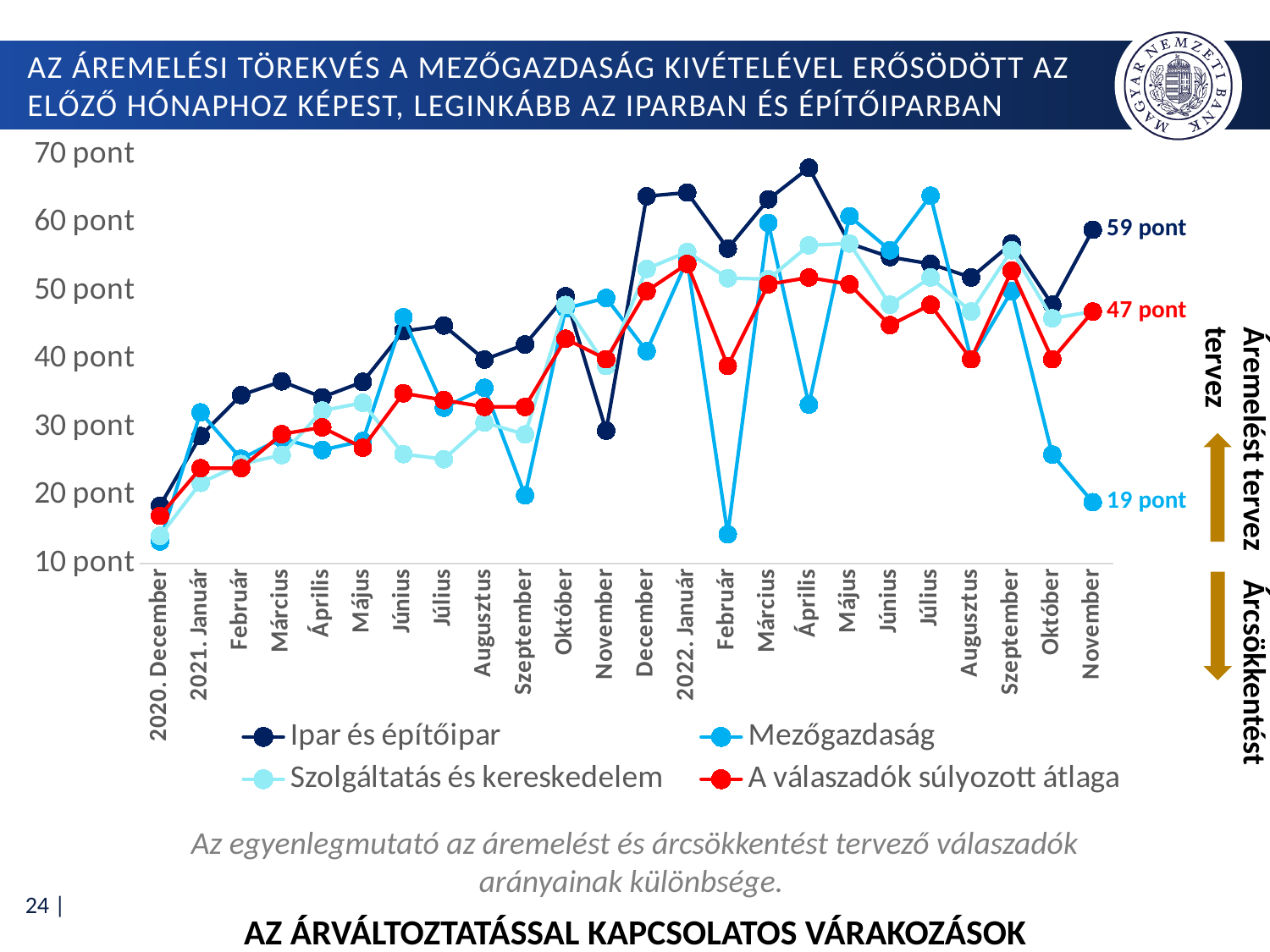
Which series has the highest value in November 2022? Ipar és építőipar What is the value for Ipar és építőipar in November 2022? 59 pont What is the difference between the November 2022 values of Ipar és építőipar and Mezőgazdaság? 40 pont How many series does the legend list? 4 Is the value for Ipar és építőipar in 2022 Április greater or less than 60 pont? greater What is the value for Mezőgazdaság in November 2022? 19 pont Does the Mezőgazdaság series rise or fall from Szeptember 2022 to November 2022? fall What is the value for A válaszadók súlyozott átlaga in November 2022? 47 pont Which series has the lowest value in November 2022? Mezőgazdaság What kind of chart is shown on the slide? line chart Is the value for Mezőgazdaság in 2022 Február greater or less than 20 pont? less How many months (data points) are shown along the x axis? 24